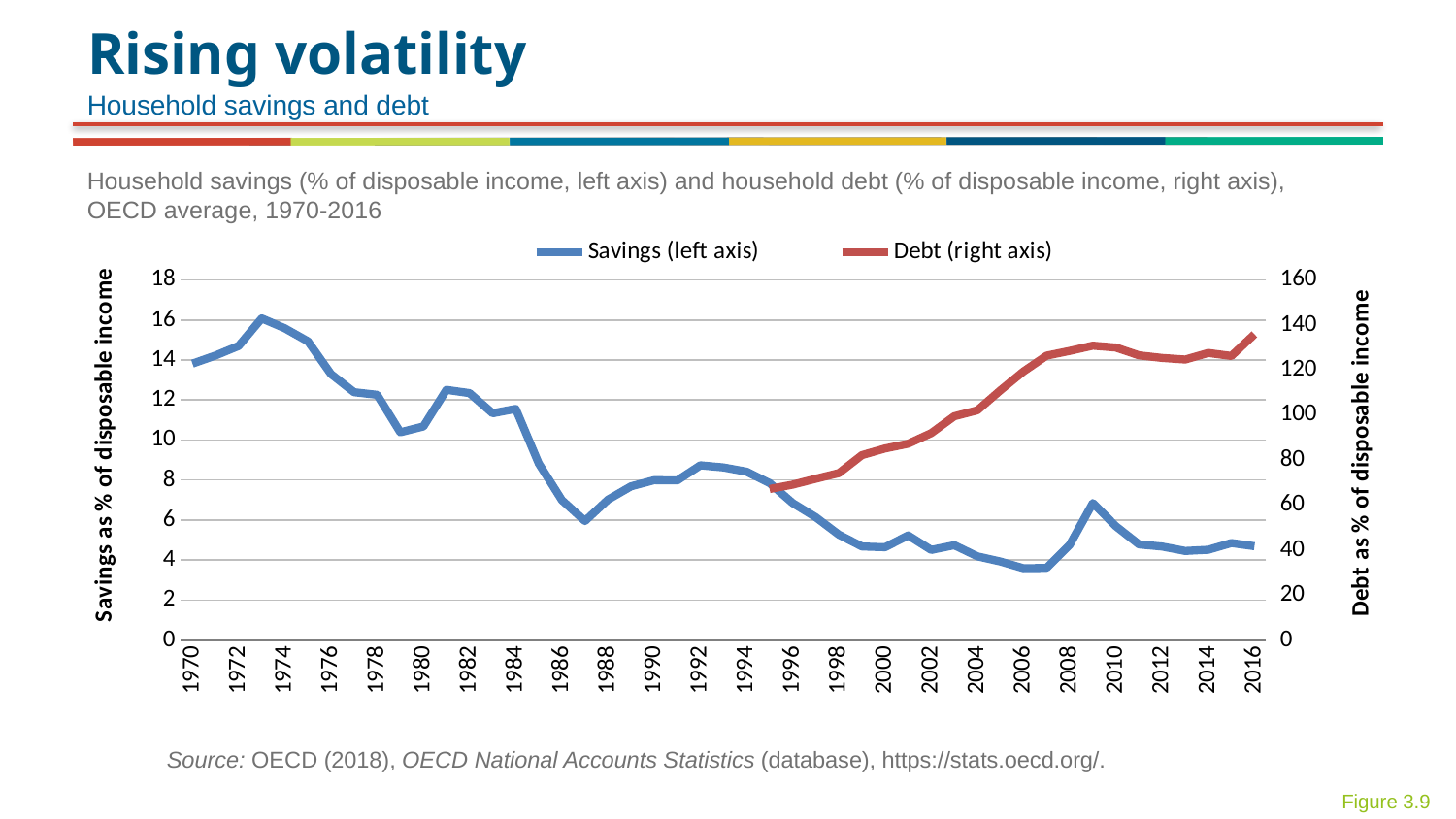
Is the Savings value for 2009 greater or less than 6? greater Is the Savings value for 1992 greater or less than 8? greater Which series is plotted against the right axis? Debt (right axis) Which year has the larger Savings value, 1973 or 2007? 1973 In which year does the Savings series reach its highest value? 1973 Is the Debt value for 2016 greater or less than 120? greater What kind of chart is shown on the slide? Line chart What colour is the Savings line? Blue How many series does the legend list? 2 Does the Savings series generally rise or fall from 1970 to 2016? Fall